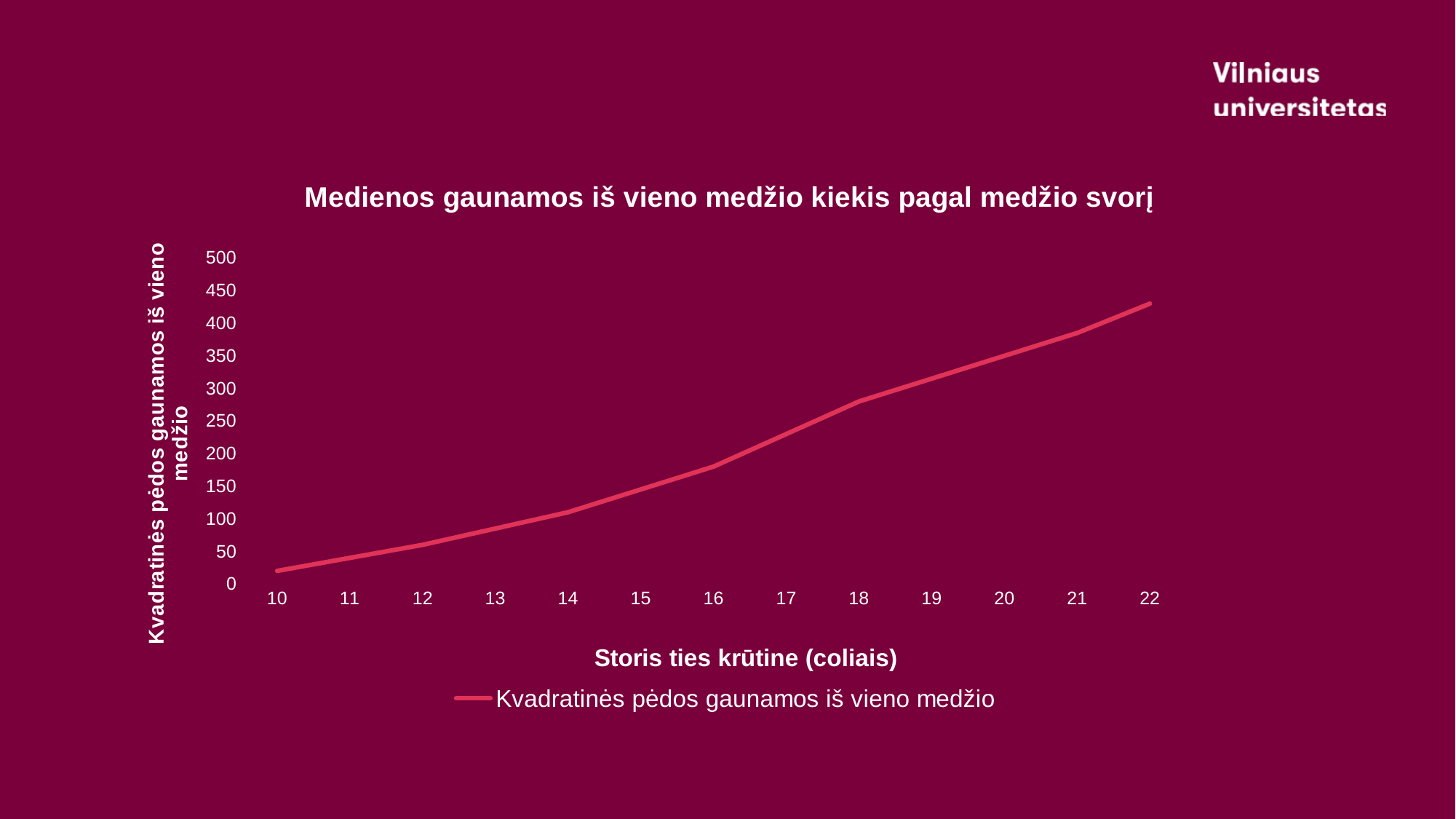
What is the title of the chart? Medienos gaunamos iš vieno medžio kiekis pagal medžio svorį What is the label of the x axis? Storis ties krūtine (coliais) Is the value at x = 10 greater or less than 50? less Is the value at x = 20 greater or less than 400? less Is the value at x = 22 greater or less than 400? greater Do the values rise or fall as the x axis goes from 10 to 22? Rise How many points are plotted along the x axis? 13 How many series does the legend list? 1 At which x-axis value is the plotted value lowest? 10 At which x-axis value is the plotted value highest? 22 What kind of chart is shown on the slide? Line chart Which is larger, the value at x = 18 or the value at x = 14? x = 18